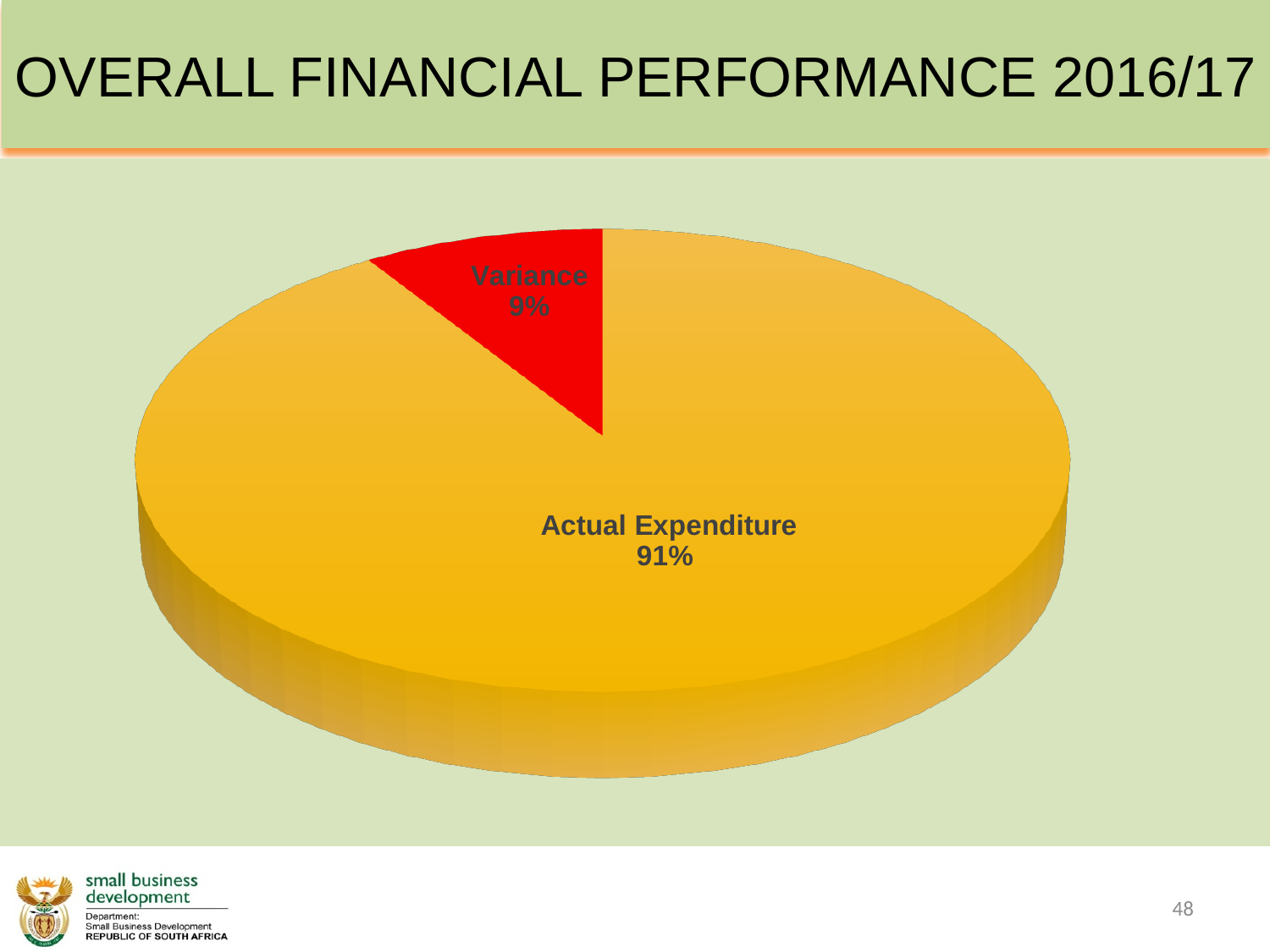
How many slices does the pie chart have? 2 What share of the pie does Variance represent? 9% What share of the pie does Actual Expenditure represent? 91% What kind of chart is shown on the slide? Pie chart What colour is the Variance slice of the pie chart? Red What is the title of the slide containing the pie chart? OVERALL FINANCIAL PERFORMANCE 2016/17 What is the difference in percentage points between the Actual Expenditure slice and the Variance slice? 82 Which is larger, the Actual Expenditure slice or the Variance slice? Actual Expenditure Which slice of the pie is the largest? Actual Expenditure Which slice of the pie is the smallest? Variance